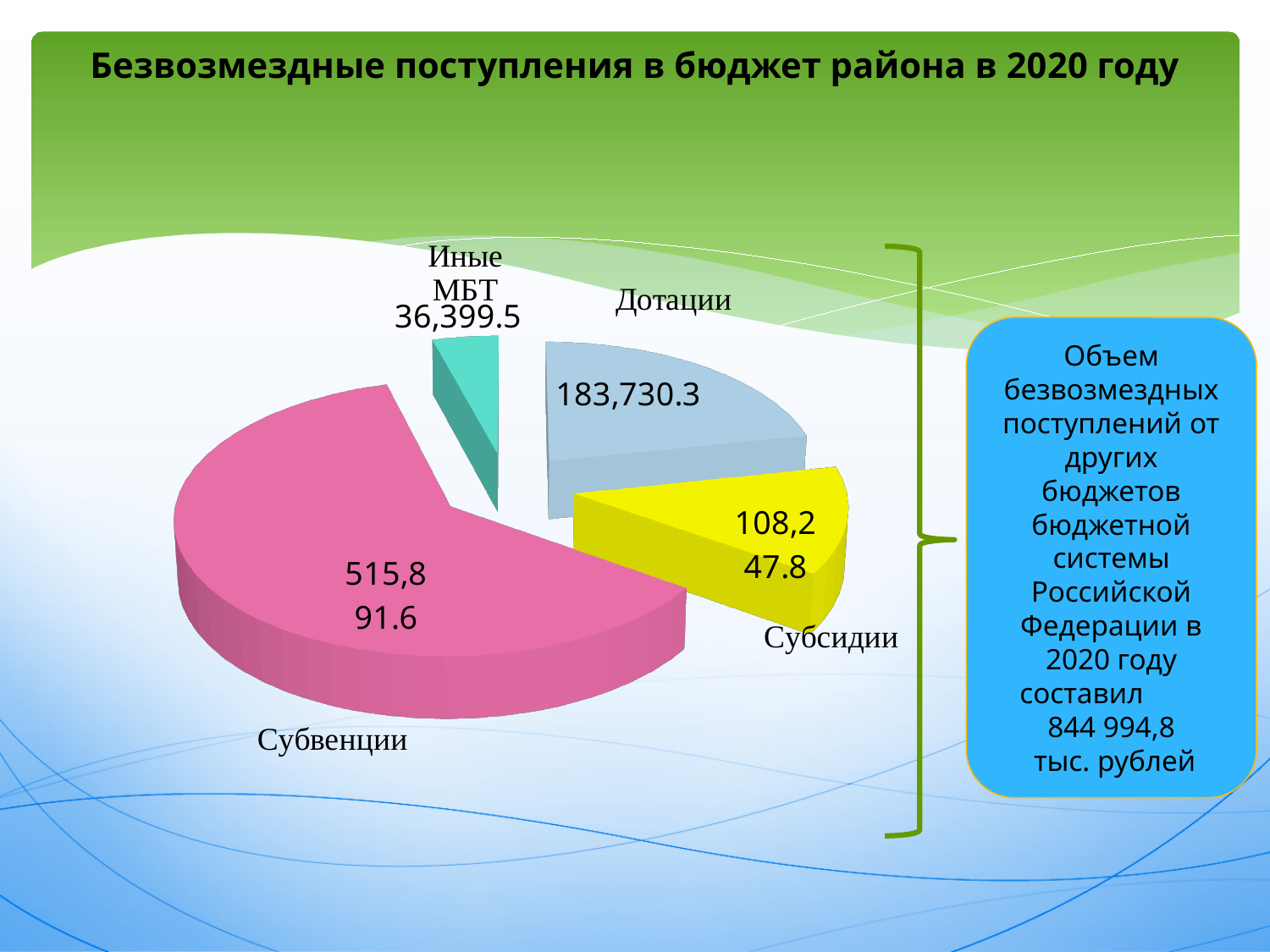
What kind of chart is shown on the slide? Pie chart What value is shown for the Иные МБТ slice? 36,399.5 What value is shown for the Субвенции slice? 515,891.6 How many categories are shown in the pie chart? 4 What value is shown for the Субсидии slice? 108,247.8 What is the difference between the values for Дотации and Иные МБТ? 147,330.8 Which category has the largest slice of the pie? Субвенции Which is larger, the value for Дотации or the value for Субсидии? Дотации Which category has the smallest slice of the pie? Иные МБТ Which is larger, the value for Субвенции or the value for Дотации? Субвенции What value is shown for the Дотации slice? 183,730.3 What is the title of the slide? Безвозмездные поступления в бюджет района в 2020 году